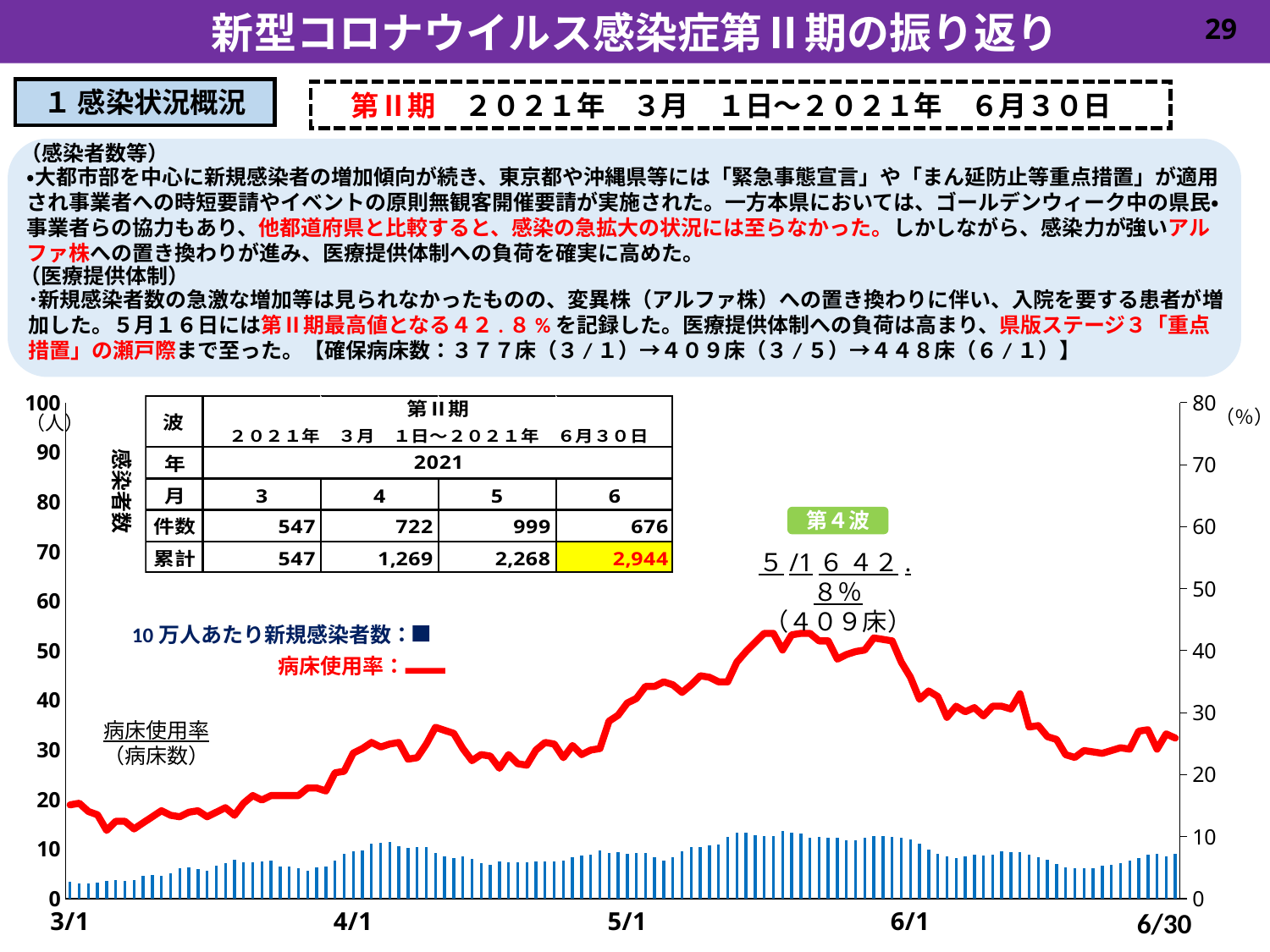
Which month in the table has the lowest number of cases (件数)? 3 Which month in the table has the highest number of cases (件数)? 5 How many beds (病床数) are noted in the annotation at the 5/16 peak? 409床 What is the difference in cases (件数) between month 5 and month 4 in the table? 277 What kind of chart is shown on the slide? A combination bar and line chart According to the table in the chart, what is the cumulative total (累計) at the end of month 6? 2,944 According to the table in the chart, how many cases (件数) were recorded in month 5? 999 What peak bed occupancy rate (病床使用率) is annotated on the chart for 5/16? 42.8% Which month has more cases (件数) in the table, month 4 or month 6? Month 4 Does the bed occupancy rate (red line) rise or fall from 3/1 to mid-May? Rise Is the bed occupancy rate (red line) at its 5/16 peak greater or less than 40%? greater How many series does the chart legend list? 2